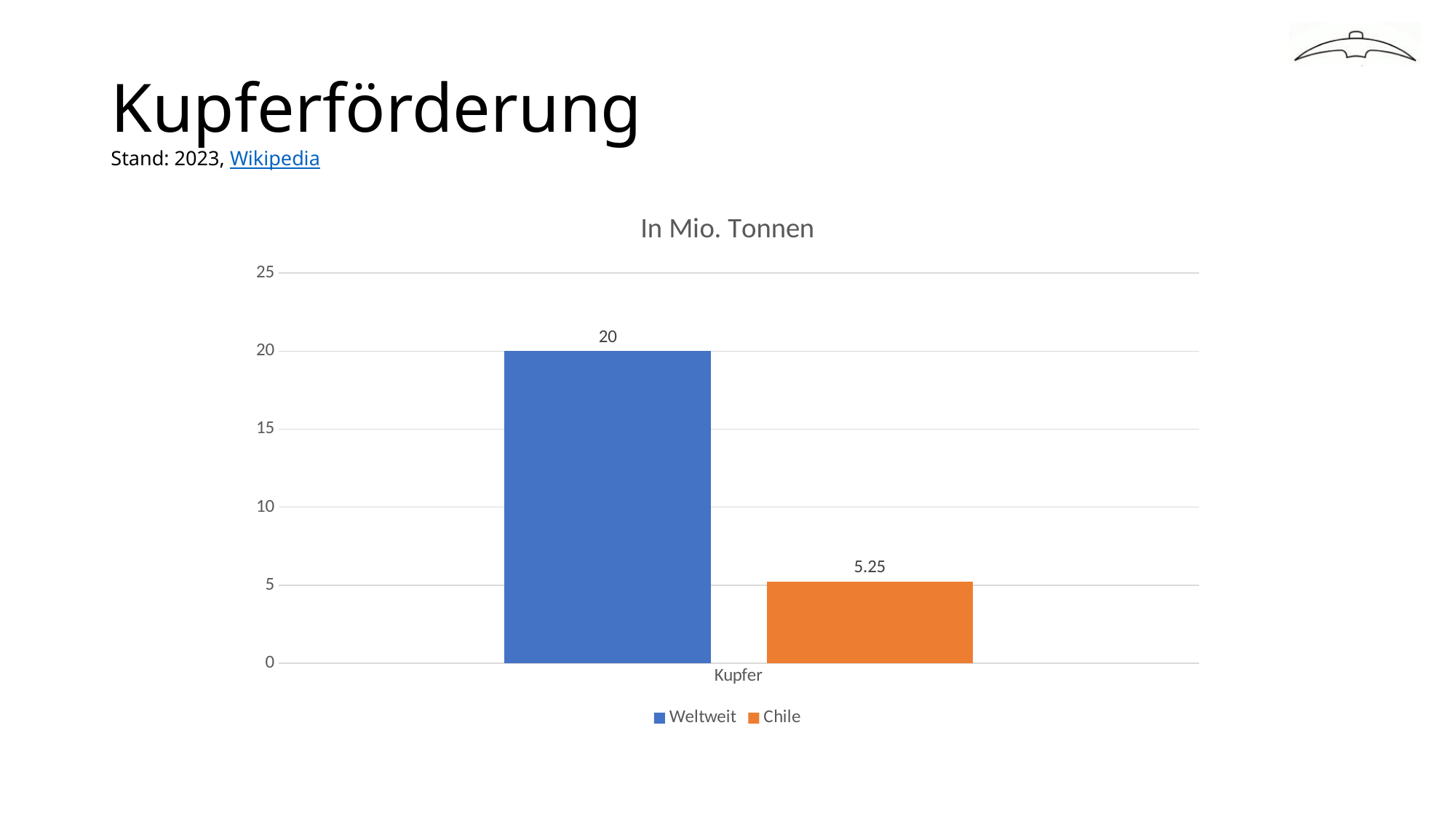
Is the value for Weltweit greater or less than 15? greater What colour is the bar for Chile? orange What is the value for Chile in the chart? 5.25 Which series has the lowest value in the chart? Chile How many series does the legend list? 2 What is the title of the chart? In Mio. Tonnen What is the difference between the Weltweit and Chile values? 14.75 What kind of chart is shown on the slide? bar chart Is the value for Chile greater or less than 10? less What is the value for Weltweit in the chart? 20 Which series has the higher value, Weltweit or Chile? Weltweit How many categories are shown on the x axis? 1